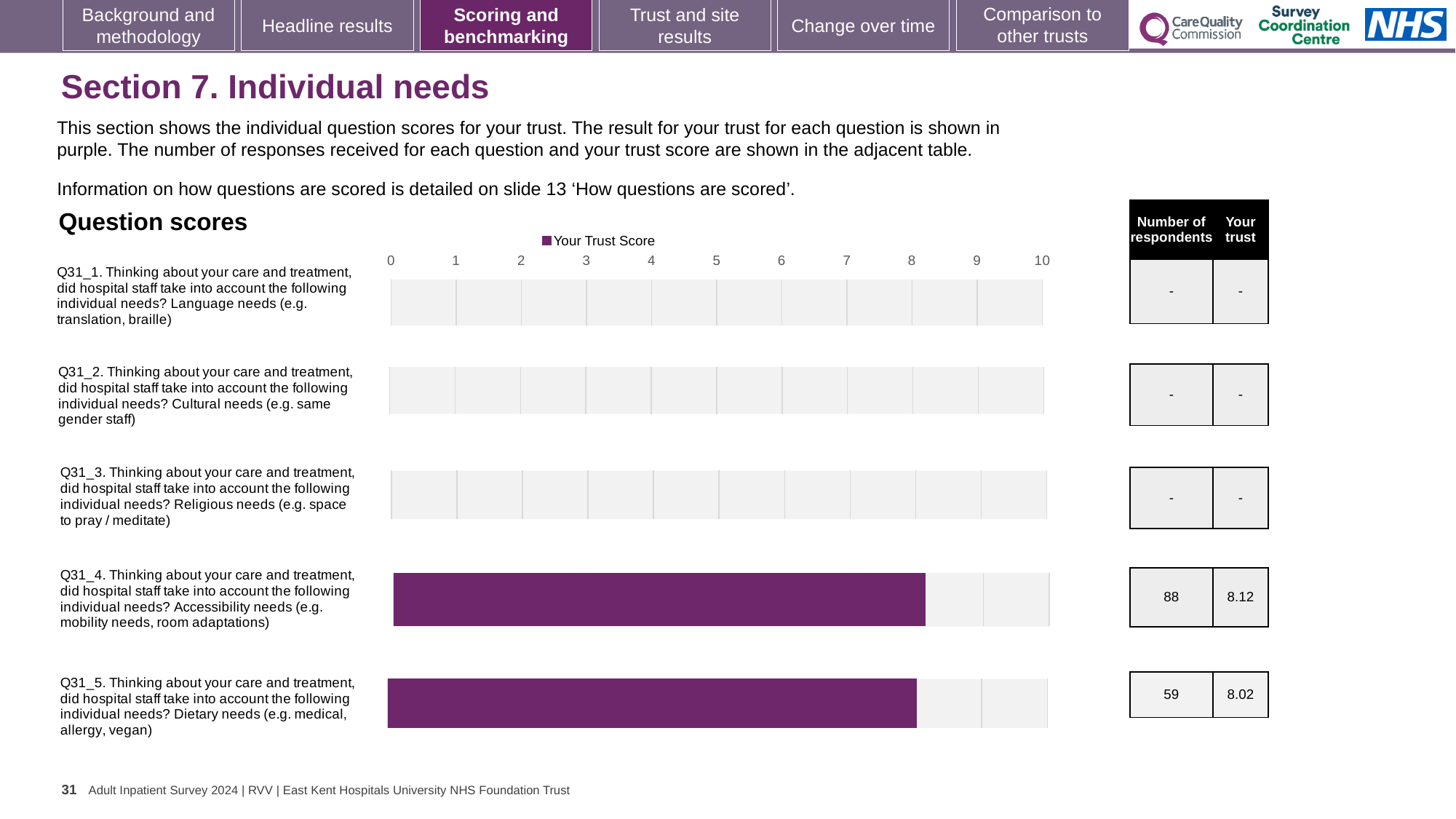
Is the value for Q31_5 (Dietary needs) greater or less than 9? less Which question has the highest trust score shown on the chart? Q31_4 (Accessibility needs) What kind of chart is shown on the slide? Bar chart Which has the larger trust score, Q31_4 (Accessibility needs) or Q31_5 (Dietary needs)? Q31_4 (Accessibility needs) What is the trust score for Q31_5 (Dietary needs)? 8.02 How many questions are listed on the chart? 5 Is the value for Q31_4 (Accessibility needs) greater or less than 8? greater What is the trust score for Q31_4 (Accessibility needs)? 8.12 How many respondents answered Q31_5 (Dietary needs)? 59 How many series does the legend list? 1 How many respondents answered Q31_4 (Accessibility needs)? 88 What is the difference between the trust scores for Q31_4 and Q31_5? 0.10